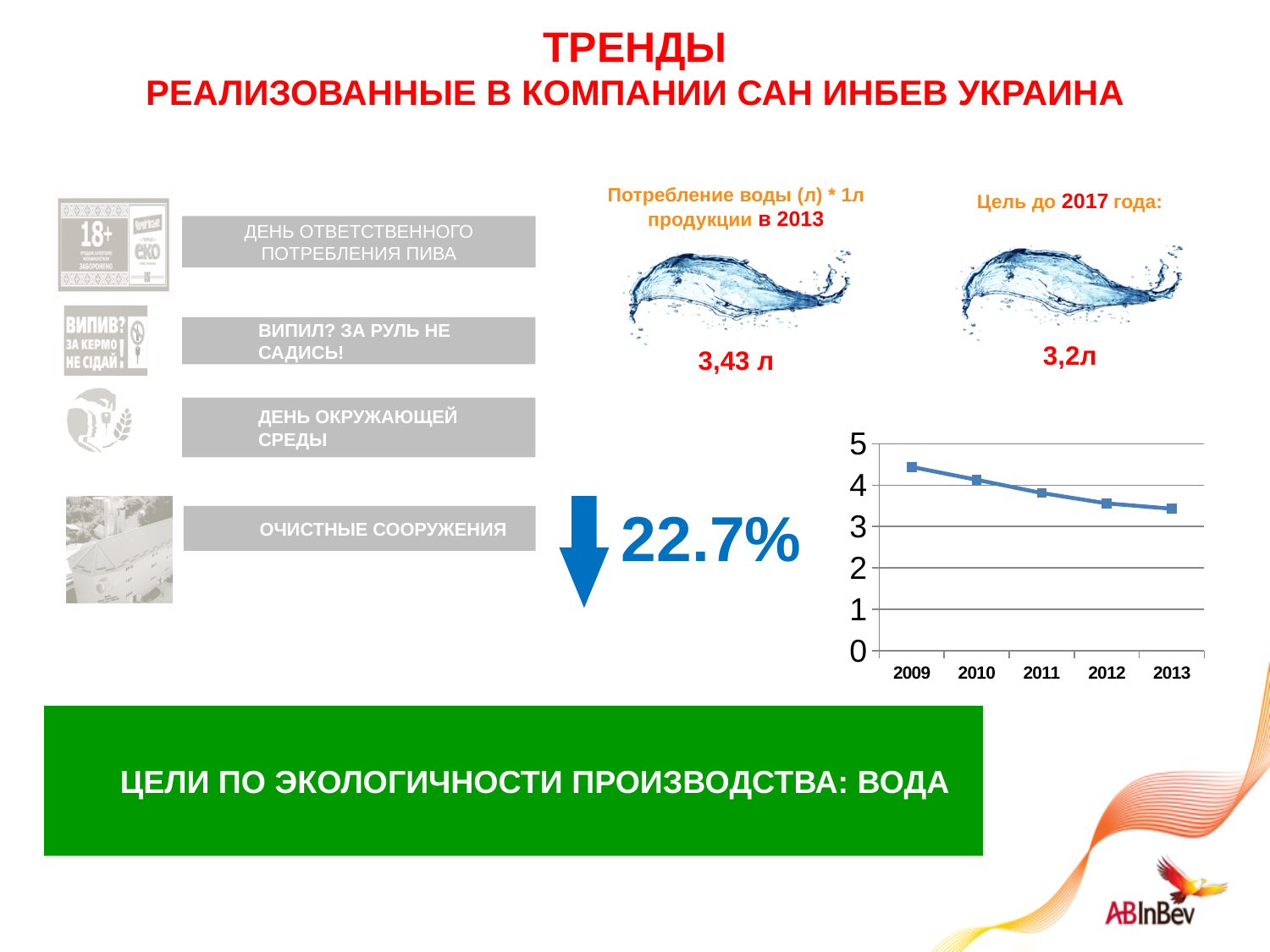
Is the value for 2013 on the line chart greater or less than 4? less What is the first year shown on the x axis of the line chart? 2009 Do the values on the line chart rise or fall from 2009 to 2013? fall What kind of chart is shown on the slide? line chart Which is larger on the line chart, the value for 2009 or the value for 2013? 2009 Which year has the highest value on the line chart? 2009 How many years are plotted on the x axis of the line chart? 5 Is the value for 2011 on the line chart greater or less than 3? greater What is the highest tick value shown on the y axis of the line chart? 5 Is the value for 2012 on the line chart greater or less than 4? less Which year has the lowest value on the line chart? 2013